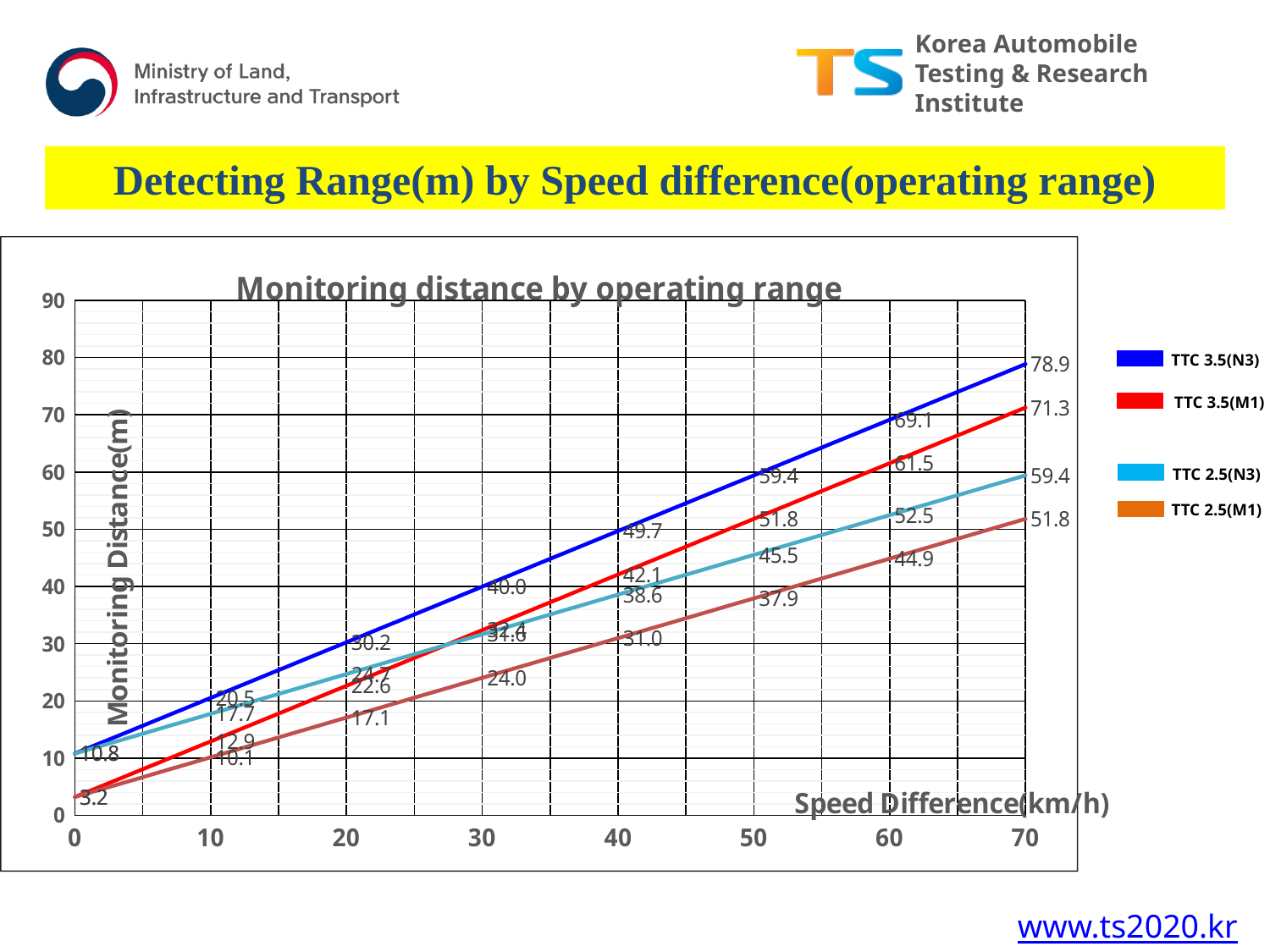
What is the monitoring distance for TTC 2.5(N3) at a speed difference of 70 km/h? 59.4 Do the monitoring distances rise or fall as the speed difference increases? rise What is the monitoring distance for TTC 2.5(M1) at a speed difference of 70 km/h? 51.8 Which series has the highest monitoring distance at a speed difference of 70 km/h? TTC 3.5(N3) What is the title of the chart? Monitoring distance by operating range What is the difference between the TTC 3.5(N3) and TTC 3.5(M1) values at a speed difference of 70 km/h? 7.6 Is the value for TTC 3.5(N3) at a speed difference of 50 km/h greater or less than 50? greater Which series has the lowest monitoring distance at a speed difference of 70 km/h? TTC 2.5(M1) What is the monitoring distance for TTC 3.5(M1) at a speed difference of 70 km/h? 71.3 What kind of chart is shown on the slide? line chart What is the monitoring distance for TTC 3.5(N3) at a speed difference of 70 km/h? 78.9 How many series does the legend list? 4